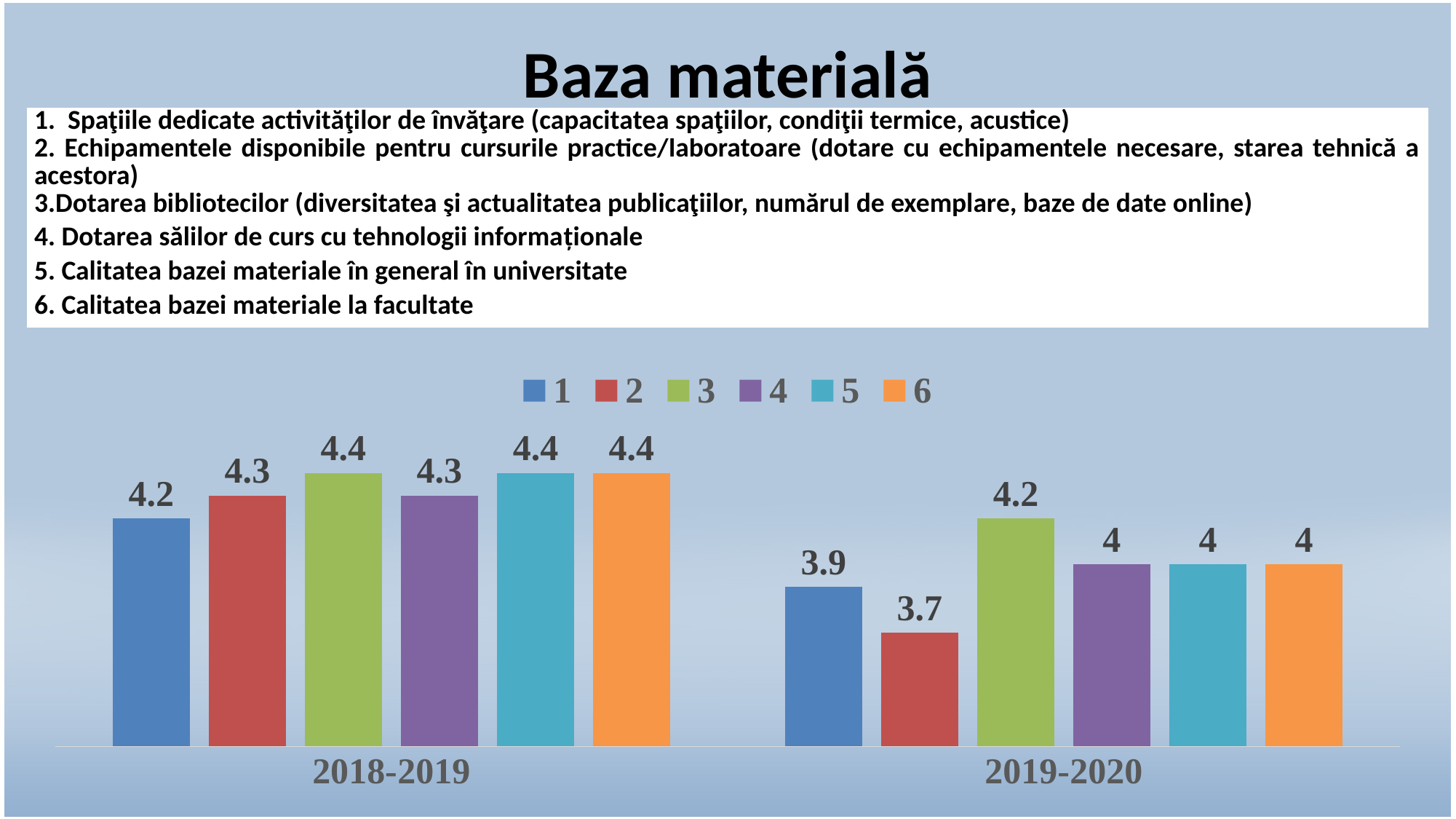
Does the value for series 4 rise or fall from 2018-2019 to 2019-2020? Fall What is the value for series 3 in 2019-2020? 4.2 What is the value for series 2 in 2019-2020? 3.7 What is the value for series 5 in 2018-2019? 4.4 How many categories are shown on the x axis? 2 What is the value for series 1 in 2018-2019? 4.2 What is the difference between the value for series 2 in 2018-2019 and in 2019-2020? 0.6 What kind of chart is shown on the slide? Bar chart Which series has the highest value in 2019-2020? 3 Which is larger: the value for series 1 in 2018-2019 or the value for series 1 in 2019-2020? 2018-2019 Which series has the lowest value in 2019-2020? 2 How many series does the legend list? 6